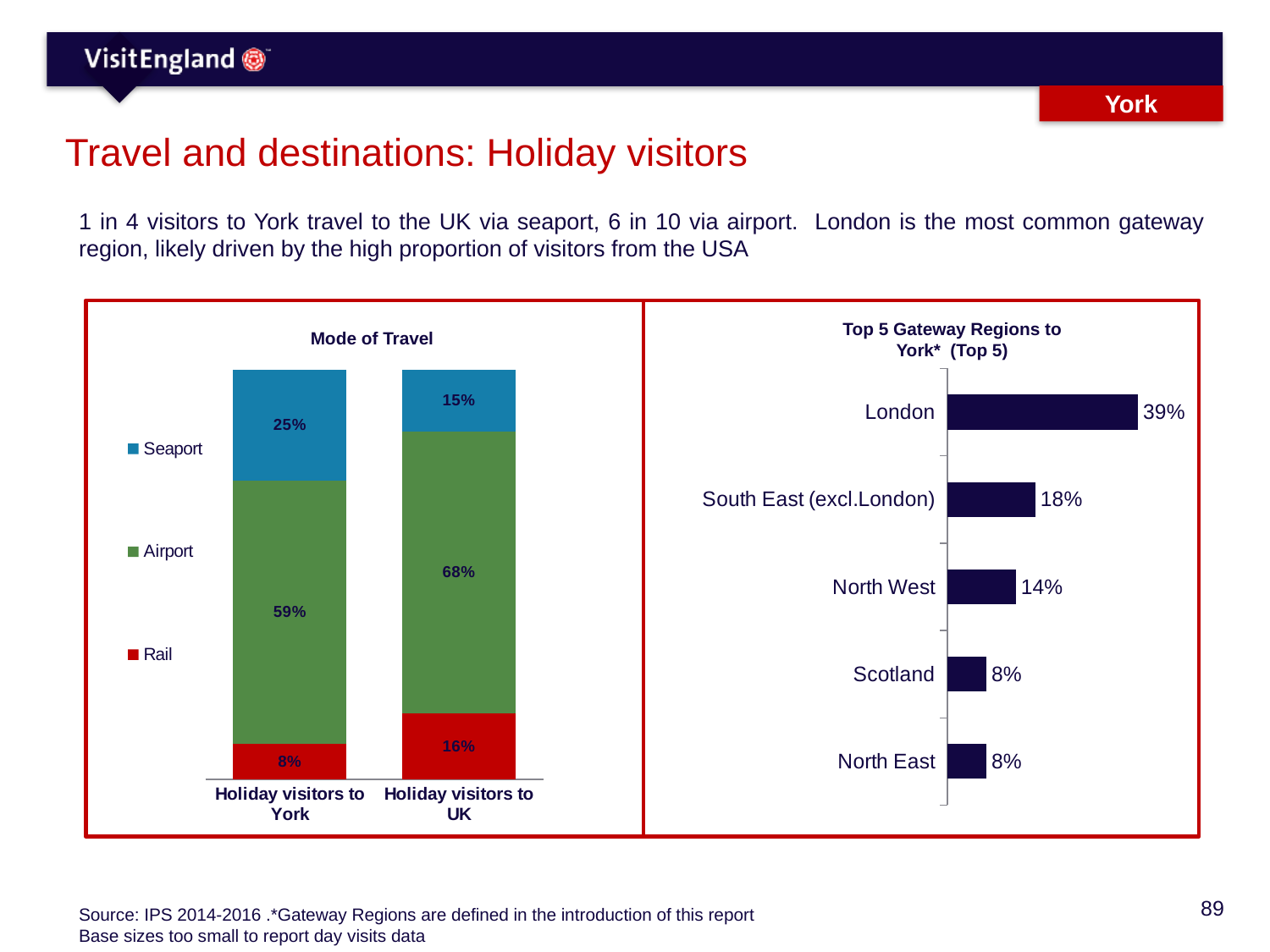
In the Top 5 Gateway Regions to York chart, what is the difference between London and South East (excl.London)? 21 percentage points In the Top 5 Gateway Regions to York chart, which region has the highest value? London In the Mode of Travel chart, which colour represents Airport? Green What kind of chart is the Mode of Travel chart? Stacked bar chart In the Mode of Travel chart, what percentage of holiday visitors to York travel by rail? 8% In the Mode of Travel chart, which is larger: the rail share for holiday visitors to York or for holiday visitors to the UK? Holiday visitors to UK How many regions are shown in the Top 5 Gateway Regions to York chart? 5 In the Mode of Travel chart, what is the difference between the airport share for holiday visitors to the UK and for holiday visitors to York? 9 percentage points In the Mode of Travel chart, what percentage of holiday visitors to the UK travel via airport? 68% How many series does the legend of the Mode of Travel chart list? 3 In the Top 5 Gateway Regions to York chart, what is the value for North West? 14% In the Mode of Travel chart, what percentage of holiday visitors to York travel via seaport? 25%